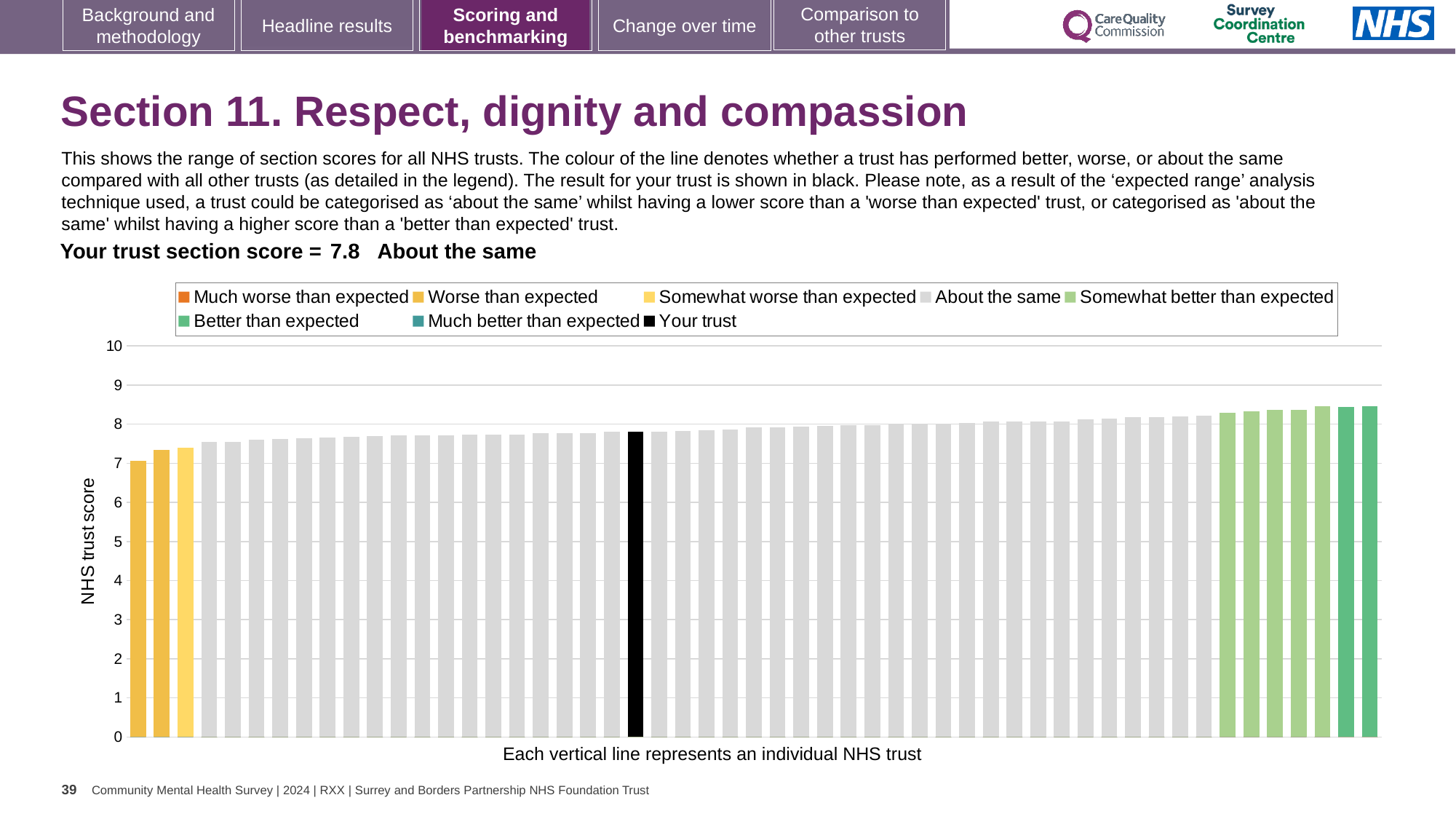
How many entries does the chart legend list? 8 What is the section score for your trust shown on the slide? 7.8 Which category is your trust placed in for Section 11? About the same Is the value of the highest bar greater or less than 9? less What kind of chart is shown on the slide? bar chart How many bars are shown in the darker green 'Better than expected' colour? 2 What colour is the bar representing your trust? black Do the bar values rise or fall from left to right along the x axis? rise What is the label on the vertical axis? NHS trust score Is the value of the lowest (leftmost) bar greater or less than 8? less Is the value of the highest (rightmost) bar greater or less than 8? greater What is the maximum value shown on the vertical axis? 10